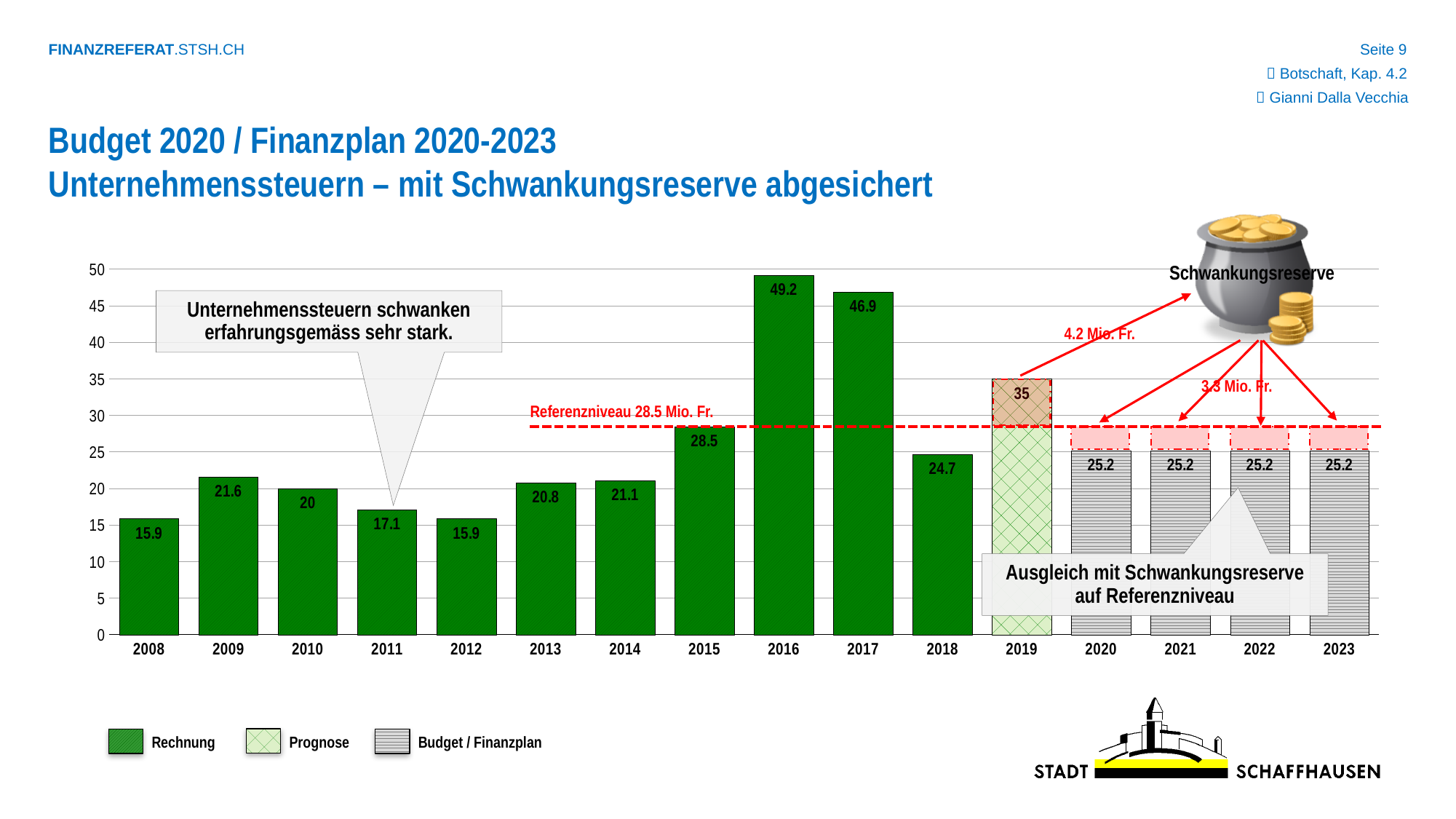
What is the value shown for 2011? 17.1 How many years are shown on the x axis of the chart? 16 What is the value shown for 2016? 49.2 How many entries does the chart legend list? 3 What is the value shown for 2019? 35 What is the difference between the values for 2016 and 2017? 2.3 Is the value for 2018 greater or less than 25? less Which year has the highest value in the chart? 2016 What value is shown for each of the years 2020 through 2023? 25.2 What kind of chart is shown on the slide? bar chart What reference level (Referenzniveau) is marked by the dashed red line? 28.5 Mio. Fr. Which is larger, the value for 2009 or the value for 2013? 2009